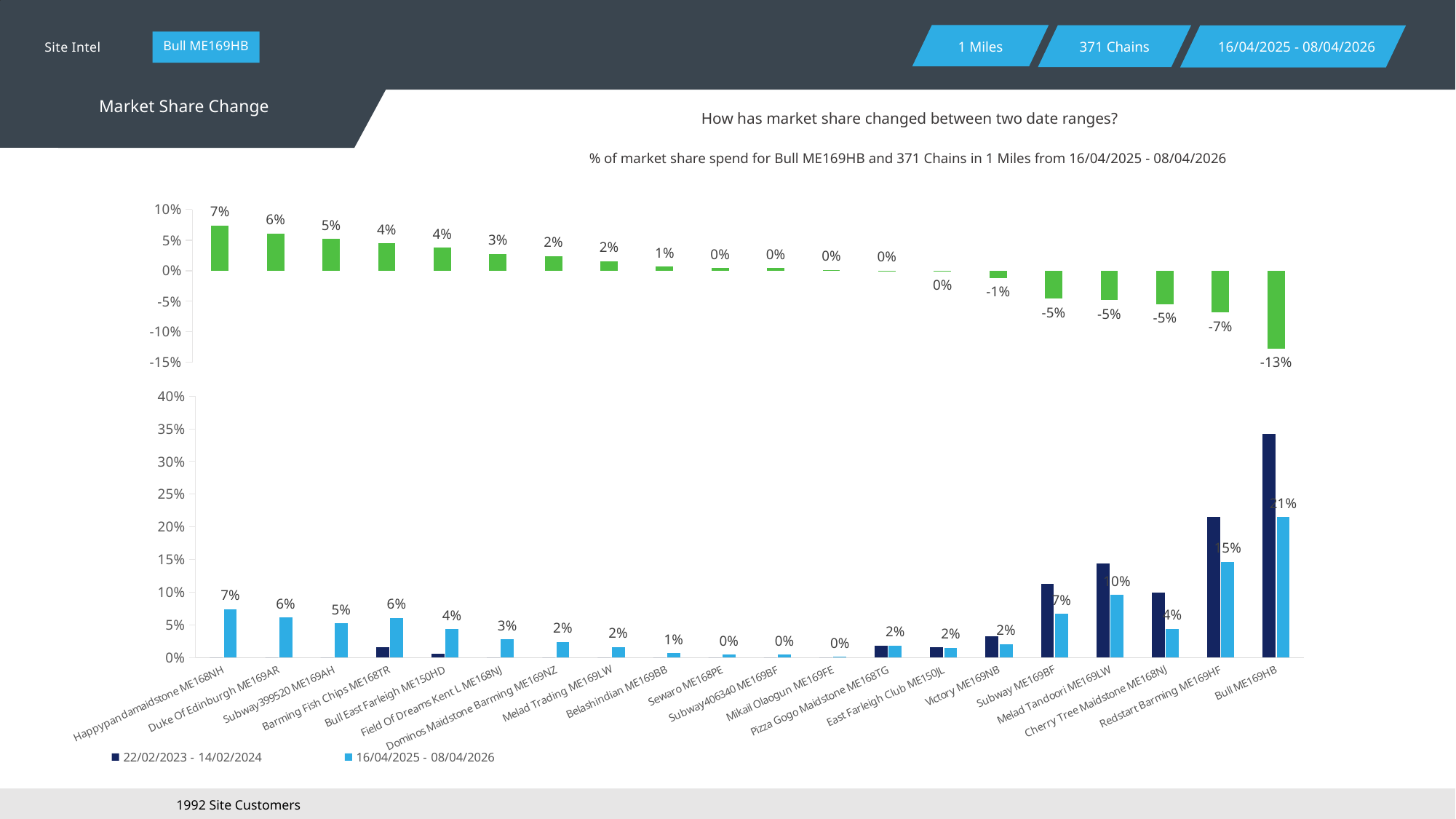
In the bottom chart, what is the difference between Bull ME169HB and Redstart Barming ME169HF in the 16/04/2025 - 08/04/2026 series? 6% What kind of chart is the top chart on the slide? Bar chart In the bottom chart, which has the larger value in the 16/04/2025 - 08/04/2026 series: Subway ME169BF or Cherry Tree Maidstone ME168NJ? Subway ME169BF In the bottom chart, what is the value for Bull ME169HB in the 16/04/2025 - 08/04/2026 series? 21% In the bottom chart, what is the value for Melad Tandoori ME169LW in the 16/04/2025 - 08/04/2026 series? 10% How many categories are shown in the top chart? 20 In the bottom chart, is the value for Bull ME169HB in the 22/02/2023 - 14/02/2024 series greater or less than 30%? greater In the top chart, do the values rise or fall from left to right along the x axis? Fall In the top chart, what is the market share change for Happypandamaidstone ME168NH? 7% How many series does the legend of the bottom chart list? 2 In the top chart, what is the market share change for Redstart Barming ME169HF? -7% In the top chart, which category has the lowest market share change? Bull ME169HB